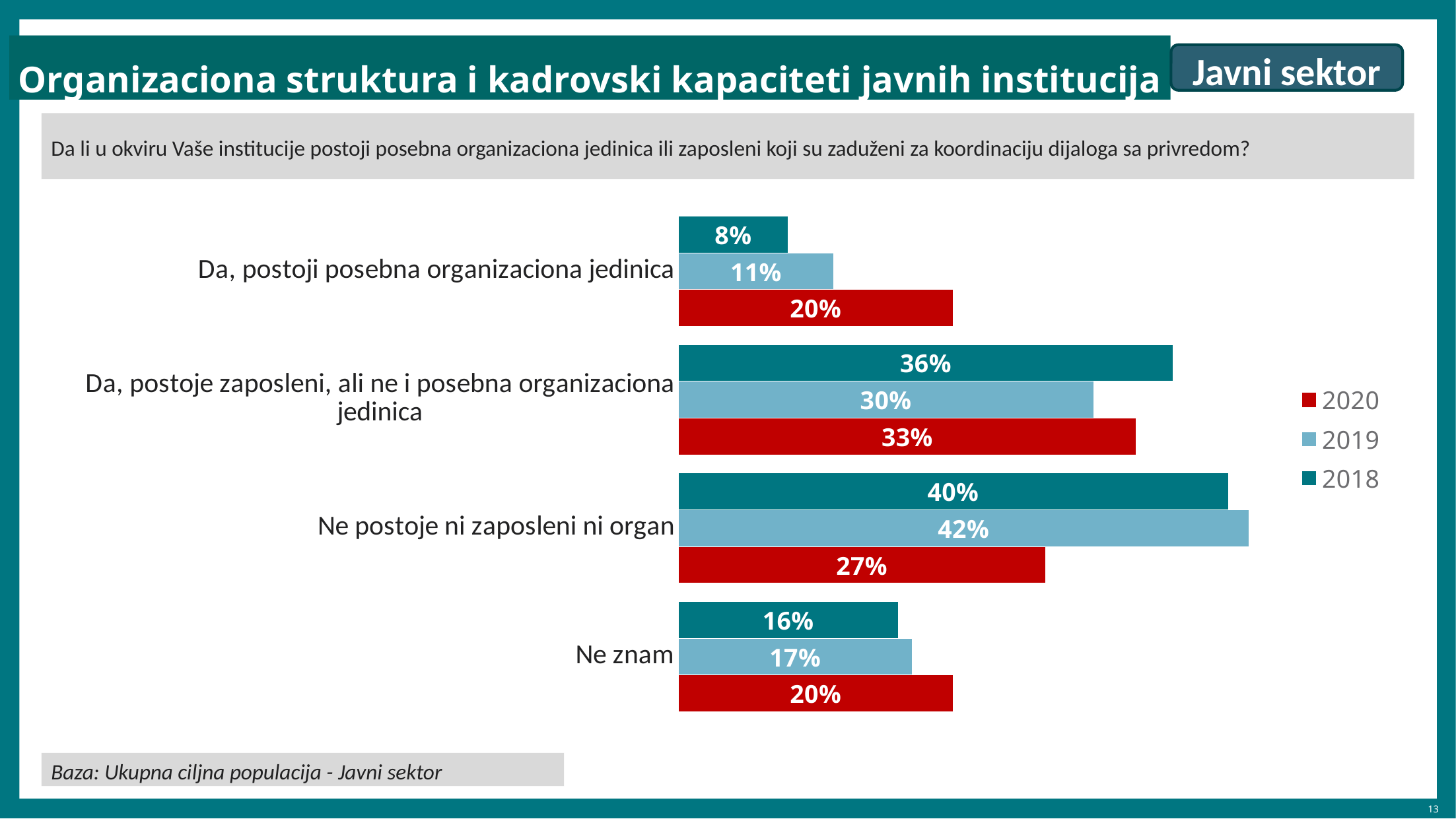
Which category has the lowest 2018 value? Da, postoji posebna organizaciona jedinica Which series is shown in red in the legend? 2020 What is the difference between the 2019 and 2020 values for "Ne postoje ni zaposleni ni organ"? 15% Which is larger for "Da, postoje zaposleni, ali ne i posebna organizaciona jedinica": the 2018 value or the 2020 value? 2018 What kind of chart is shown on the slide? Bar chart How many series does the legend list? 3 What is the difference between the 2020 and 2018 values for "Da, postoji posebna organizaciona jedinica"? 12% What is the 2018 value for "Ne postoje ni zaposleni ni organ"? 40% What is the 2019 value for "Ne znam"? 17% Which category has the highest 2019 value? Ne postoje ni zaposleni ni organ What is the 2020 value for "Da, postoji posebna organizaciona jedinica"? 20% How many categories are shown on the chart? 4